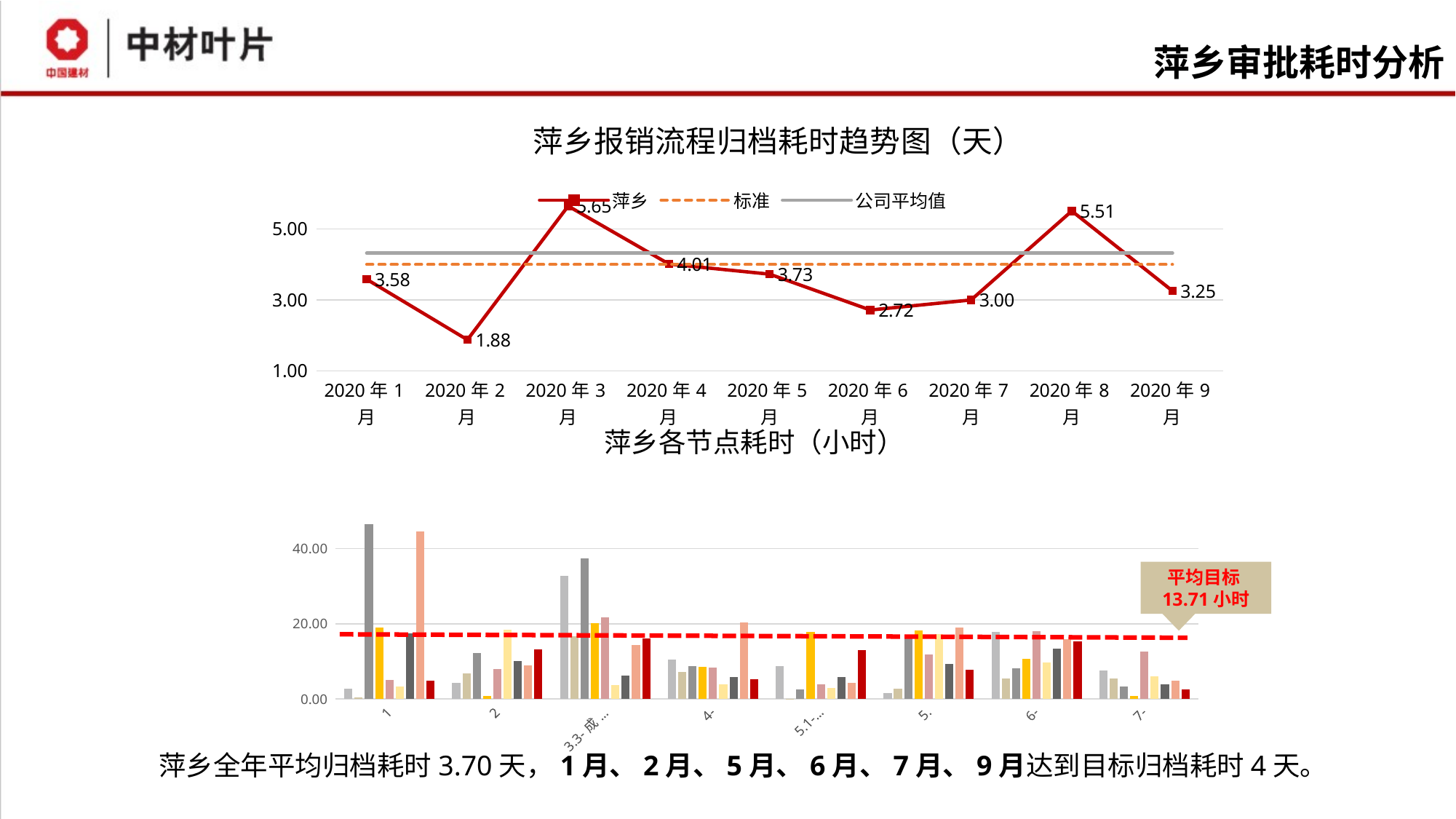
在“萍乡报销流程归档耗时趋势图（天）”中，哪个月的萍乡归档耗时最高？ 2020年3月 “萍乡各节点耗时（小时）”是什么类型的图表？ 柱状图 在“萍乡报销流程归档耗时趋势图（天）”中，2020年3月的萍乡归档耗时是多少？ 5.65 在“萍乡各节点耗时（小时）”图中，标注的平均目标是多少小时？ 13.71 小时 “萍乡报销流程归档耗时趋势图（天）”是什么类型的图表？ 折线图 在“萍乡报销流程归档耗时趋势图（天）”中，哪个月的萍乡归档耗时最低？ 2020年2月 在“萍乡报销流程归档耗时趋势图（天）”中，2020年8月与2020年9月的萍乡归档耗时相差多少？ 2.26 在“萍乡报销流程归档耗时趋势图（天）”中，2020年4月和2020年7月哪个月的萍乡归档耗时更高？ 2020年4月 “萍乡报销流程归档耗时趋势图（天）”的图例列出了几个系列？ 3 在“萍乡报销流程归档耗时趋势图（天）”中，2020年6月的萍乡归档耗时是多少？ 2.72 在“萍乡报销流程归档耗时趋势图（天）”中，从2020年3月到2020年6月，萍乡归档耗时是上升还是下降？ 下降 在“萍乡报销流程归档耗时趋势图（天）”中，萍乡折线共有多少个数据点？ 9